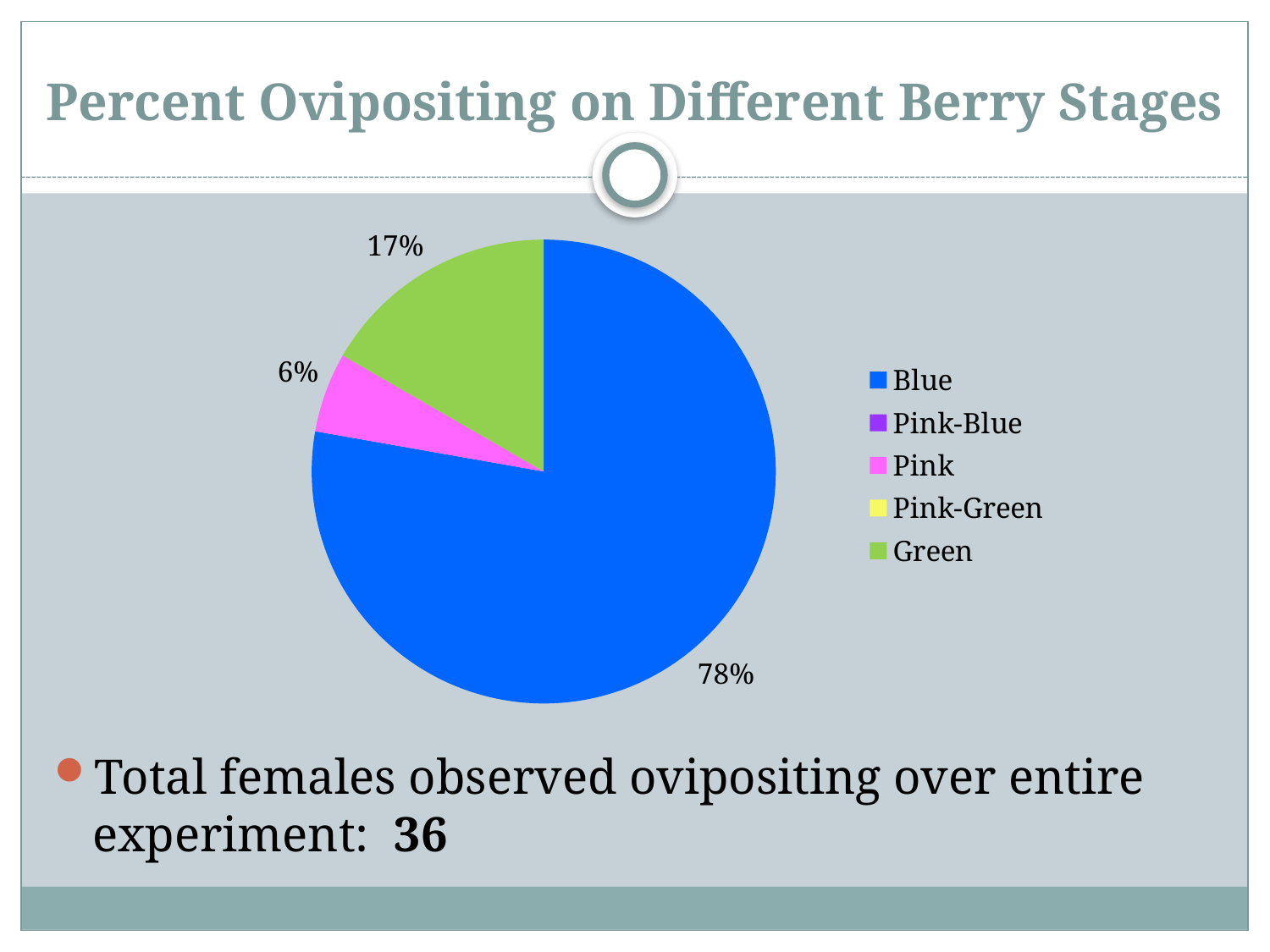
What kind of chart is shown on the slide? pie chart Of the slices with printed labels, which berry stage has the smallest share? Pink Which slice is larger, Green or Pink? Green What is the title of the chart? Percent Ovipositing on Different Berry Stages How many entries does the legend list? 5 Which berry stage has the largest share of the pie? Blue Which legend entry is shown in green? Green What is the difference in percentage points between the Blue and Green slices? 61 What percentage of the pie is the Blue slice? 78% What is the difference in percentage points between the Green and Pink slices? 11 What percentage of the pie is the Green slice? 17% What percentage of the pie is the Pink slice? 6%